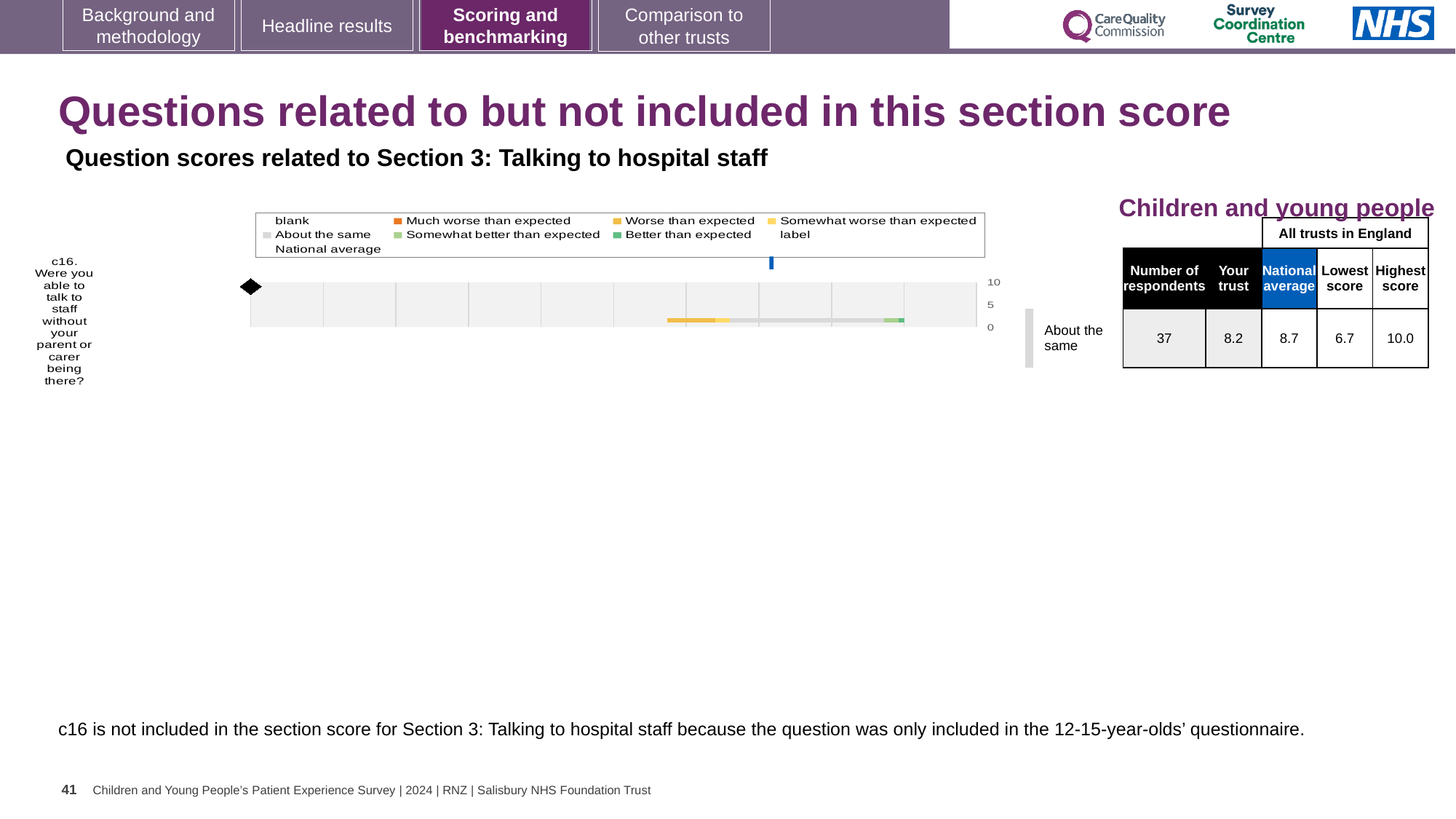
In the table beside the chart, what is the 'Your trust' score for c16? 8.2 How many survey questions are plotted in the chart? 1 In the table beside the chart, how many respondents answered c16? 37 What is the highest value shown on the chart's numeric axis? 10 In the table beside the chart, what is the lowest score among all trusts in England for c16? 6.7 What benchmark category is shown next to the bar for c16? About the same In the table beside the chart, what is the national average score for c16? 8.7 In the table beside the chart, what is the highest score among all trusts in England for c16? 10.0 What kind of chart is shown on the slide for question c16? bar chart In the table beside the chart, which is larger for c16: the trust's score or the national average? national average Which question code is plotted in the chart? c16 Which legend entry is shown in orange in the chart? Much worse than expected